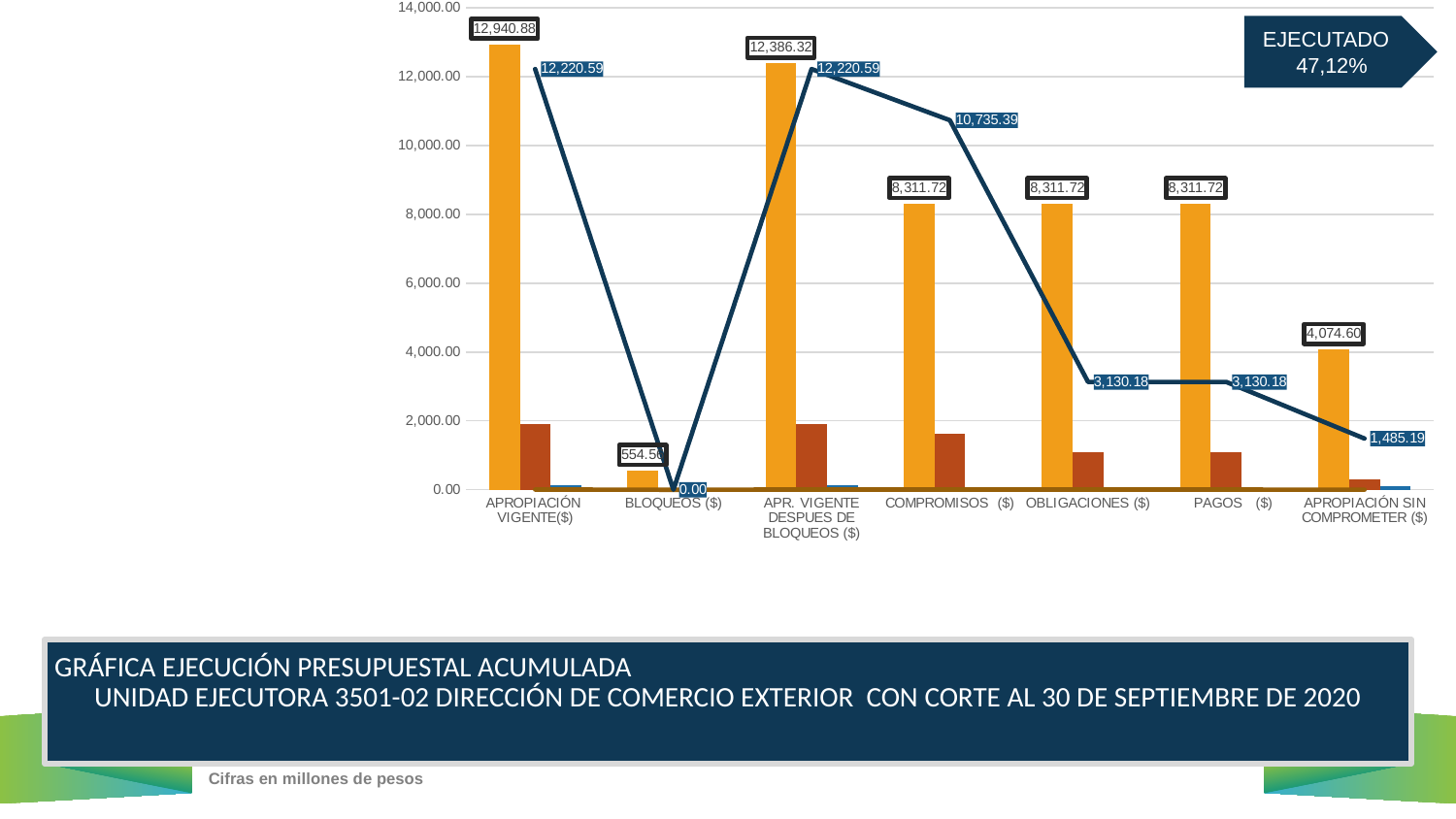
What is the value of the orange bar for APROPIACIÓN SIN COMPROMETER ($)? 4,074.60 At COMPROMISOS ($), which is larger: the orange bar value or the line value? The line value (10,735.39) What is the value of the orange bar for APROPIACIÓN VIGENTE($)? 12,940.88 What execution percentage (EJECUTADO) is shown in the box on the slide? 47,12% How many categories are shown on the x axis? 7 What kind of chart is this? A combination bar and line chart Does the line rise or fall from OBLIGACIONES ($) to APROPIACIÓN SIN COMPROMETER ($)? It falls Is the dark red bar for OBLIGACIONES ($) greater or less than 2,000.00? less What value does the line show for COMPROMISOS ($)? 10,735.39 What is the difference between the orange bar values for APROPIACIÓN VIGENTE($) and APR. VIGENTE DESPUES DE BLOQUEOS ($)? 554.56 Which category has the highest orange bar? APROPIACIÓN VIGENTE($) Which category has the lowest value on the line? BLOQUEOS ($)